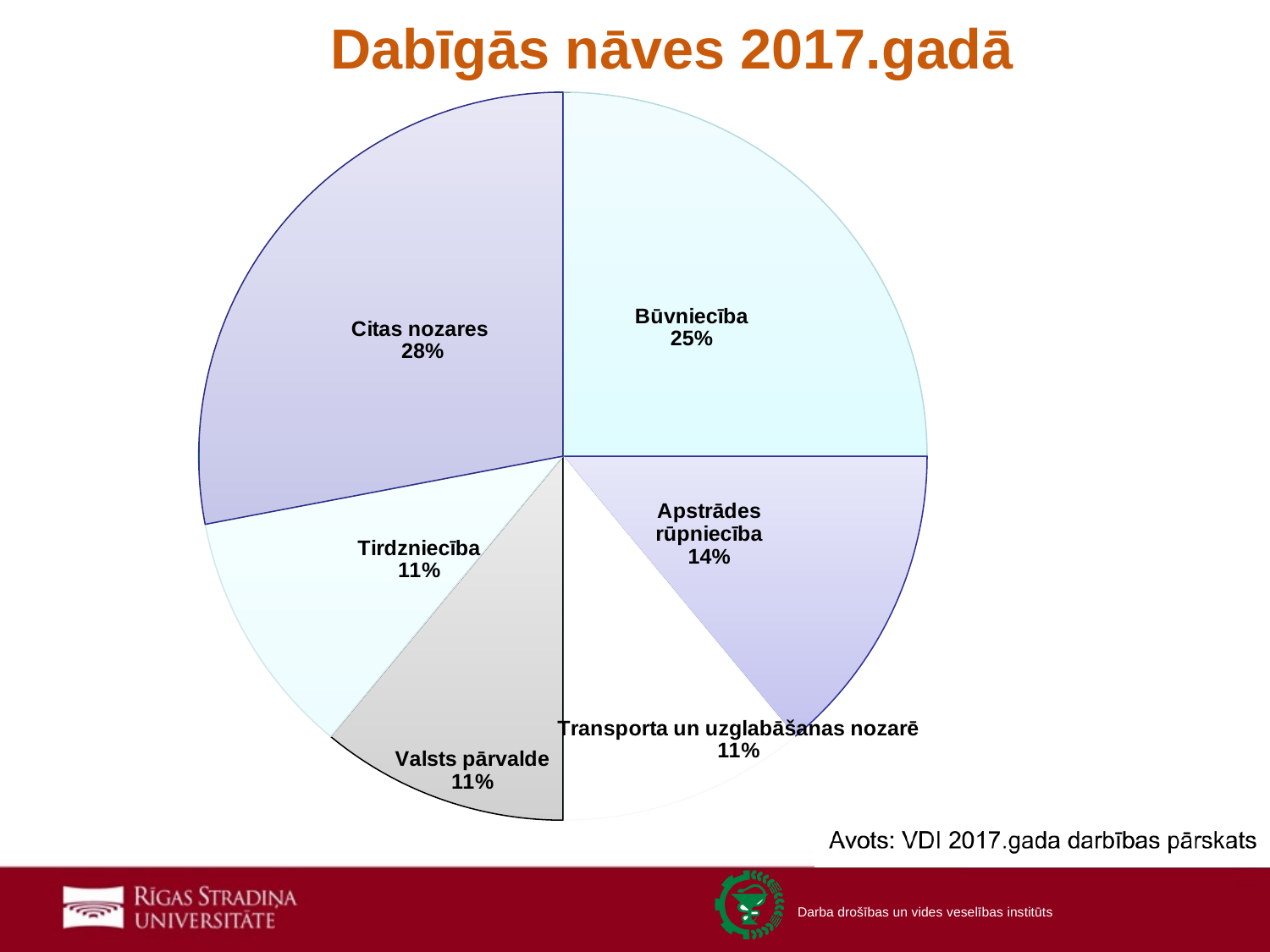
What kind of chart is shown on the slide? Pie chart What is the difference in percentage points between Būvniecība and Apstrādes rūpniecība? 11 What is the title of the chart? Dabīgās nāves 2017.gadā What share of the pie does Citas nozares have? 28% What is the difference in percentage points between Citas nozares and Būvniecība? 3 How many slices does the pie chart have? 6 Which is larger, the share for Būvniecība or the share for Apstrādes rūpniecība? Būvniecība What share of the pie does Valsts pārvalde have? 11% What share of the pie does Būvniecība have? 25% What share of the pie does Apstrādes rūpniecība have? 14% Which is larger, the share for Citas nozares or the share for Tirdzniecība? Citas nozares Which category has the largest slice of the pie? Citas nozares